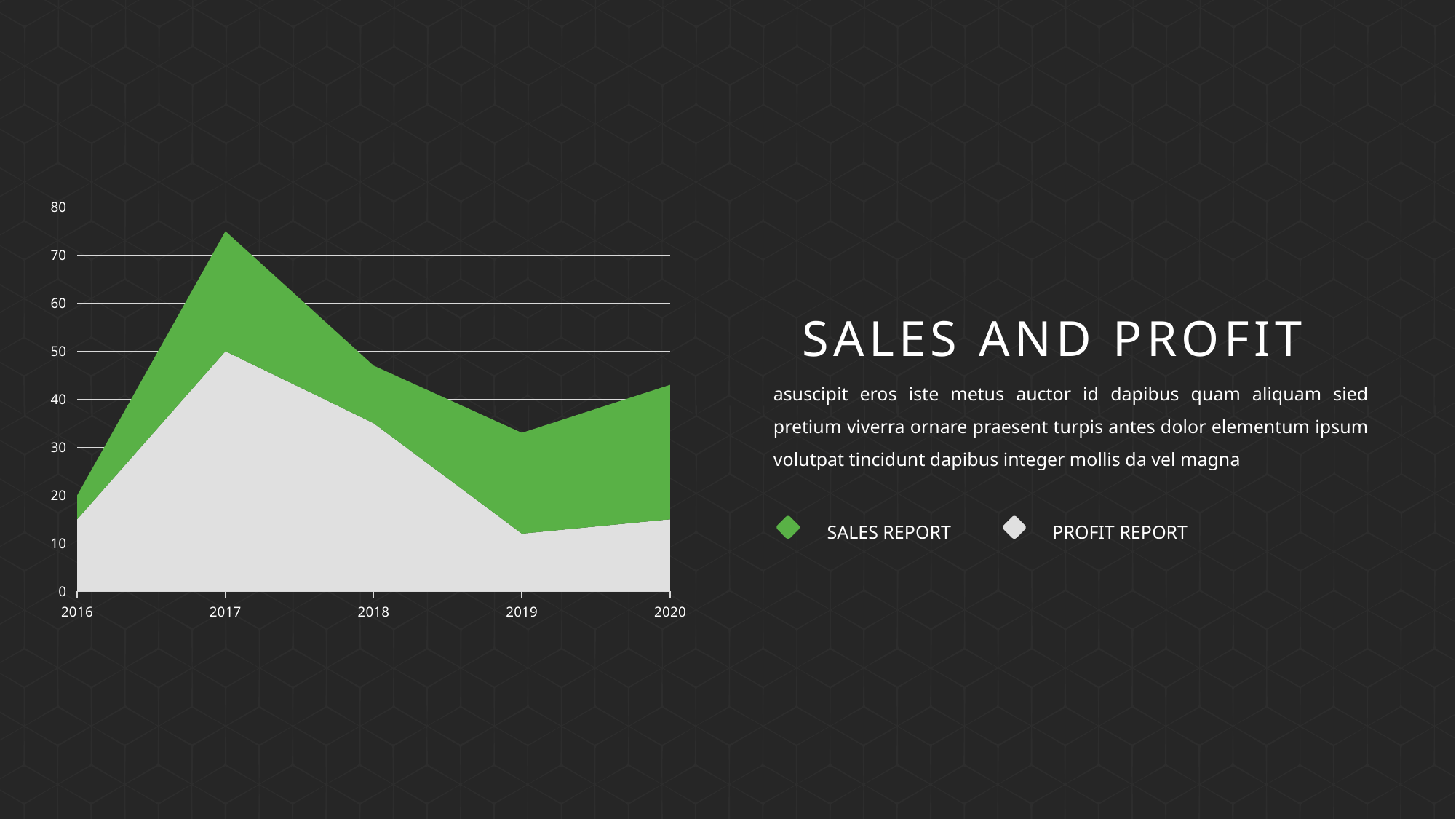
In which year is the Sales Report value lowest? 2016 How many series does the legend list? 2 Is the Sales Report value for 2020 greater or less than 40? less In which year does the Sales Report series reach its highest value? 2020 What is the title shown next to the chart? SALES AND PROFIT Which colour represents the Sales Report series? Green Is the Sales Report value for 2017 greater or less than 70? less What kind of chart is shown on the slide? Area chart Is the Profit Report value for 2019 greater or less than 20? less How many years are plotted along the x axis? 5 In which year does the Profit Report series reach its highest value? 2017 Does the Sales Report series rise or fall from 2017 to 2019? fall